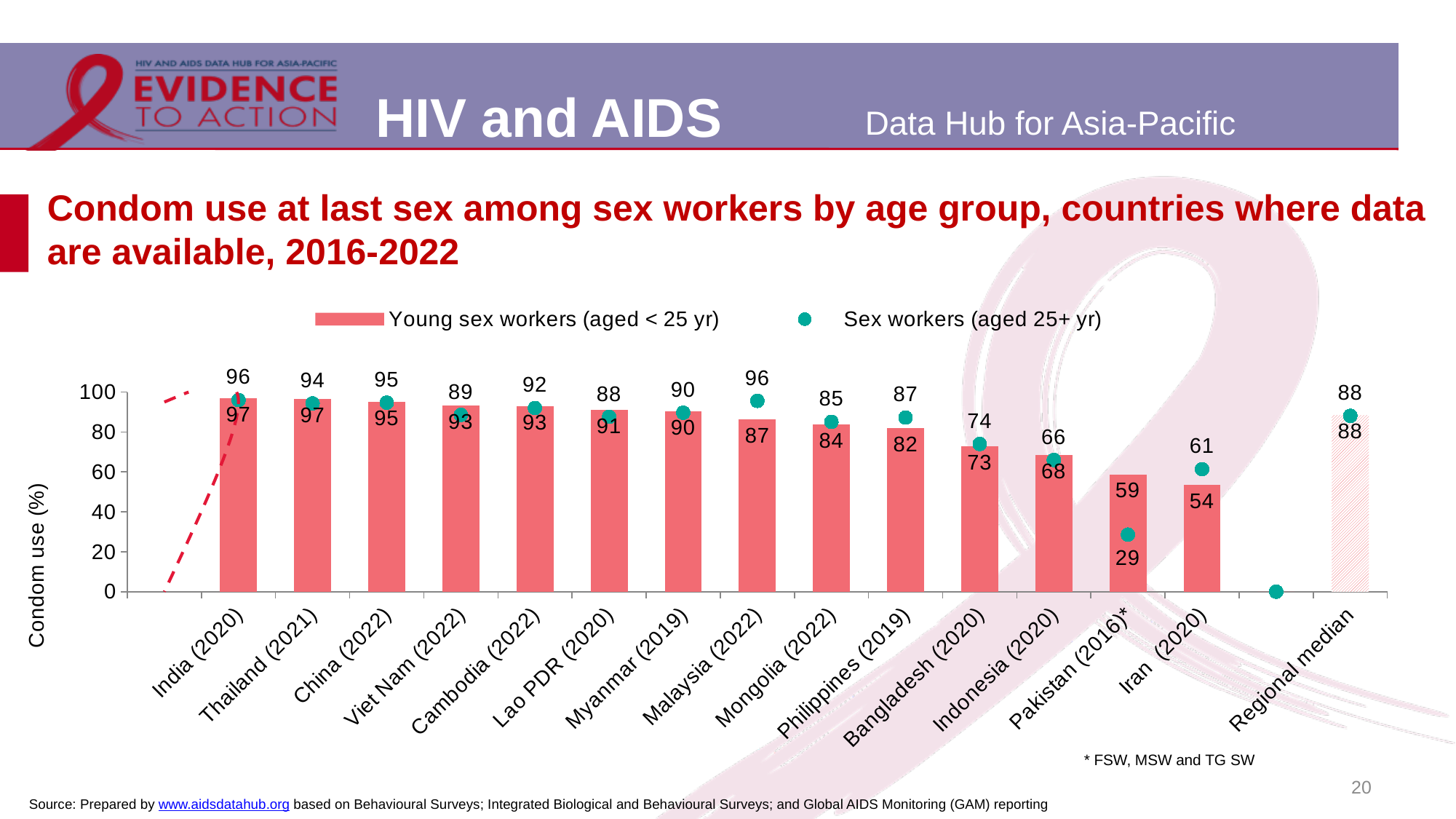
What kind of chart is used to show condom use among young sex workers? Bar chart In Iran (2020), which group has higher condom use: young sex workers (aged < 25 yr) or sex workers (aged 25+ yr)? Sex workers (aged 25+ yr) Do the bar values for young sex workers generally rise or fall from India (2020) to Iran (2020)? Fall What is the condom use value for sex workers (aged 25+ yr) in Malaysia (2022)? 96 Which country has the lowest condom use among young sex workers (aged < 25 yr)? Iran (2020) Which country has the lowest condom use among sex workers (aged 25+ yr)? Pakistan (2016)* What is the difference between condom use among young sex workers and sex workers aged 25+ in Pakistan (2016)*? 30 What is the condom use value for sex workers (aged 25+ yr) in Pakistan (2016)*? 29 What is the condom use value for young sex workers (aged < 25 yr) in Pakistan (2016)*? 59 How many series does the legend list? 2 What is the regional median condom use for young sex workers (aged < 25 yr)? 88 What is the condom use value for young sex workers (aged < 25 yr) in Bangladesh (2020)? 73